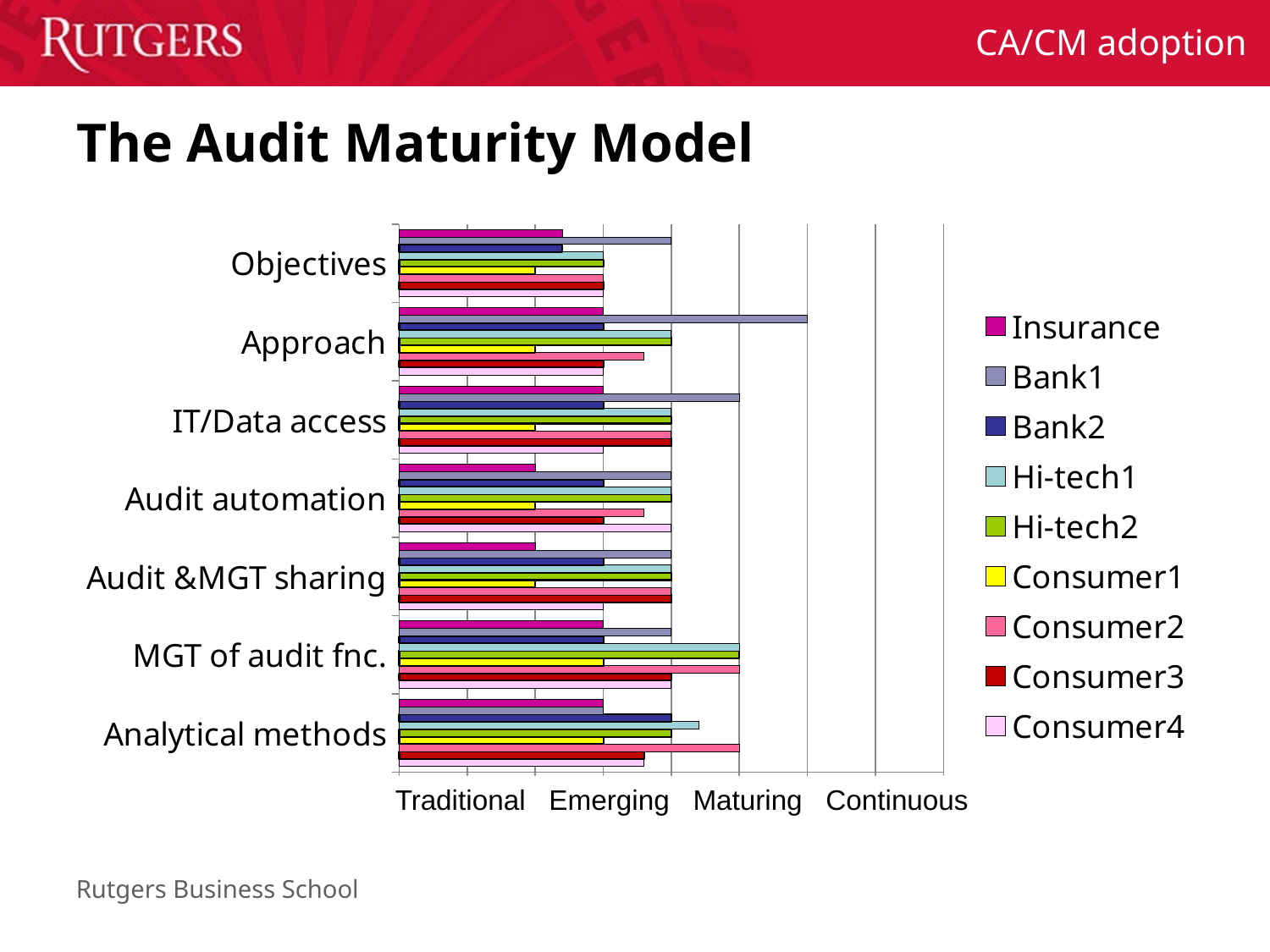
What kind of chart is shown on the slide? bar chart In the MGT of audit fnc. category, which bar is longer: Hi-tech1 or Insurance? Hi-tech1 For the Approach category, which series has the longest bar? Bank1 For the Analytical methods category, which series has the longest bar? Consumer2 In the Analytical methods category, which bar is longer: Consumer2 or Insurance? Consumer2 How many categories are plotted on the vertical axis of the chart? 7 What is the title of the slide containing the chart? The Audit Maturity Model What are the four labels shown along the horizontal axis of the chart? Traditional, Emerging, Maturing, Continuous In the Audit automation category, which bar is longer: Bank2 or Insurance? Bank2 For the IT/Data access category, which series has the longest bar? Bank1 How many series does the chart's legend list? 9